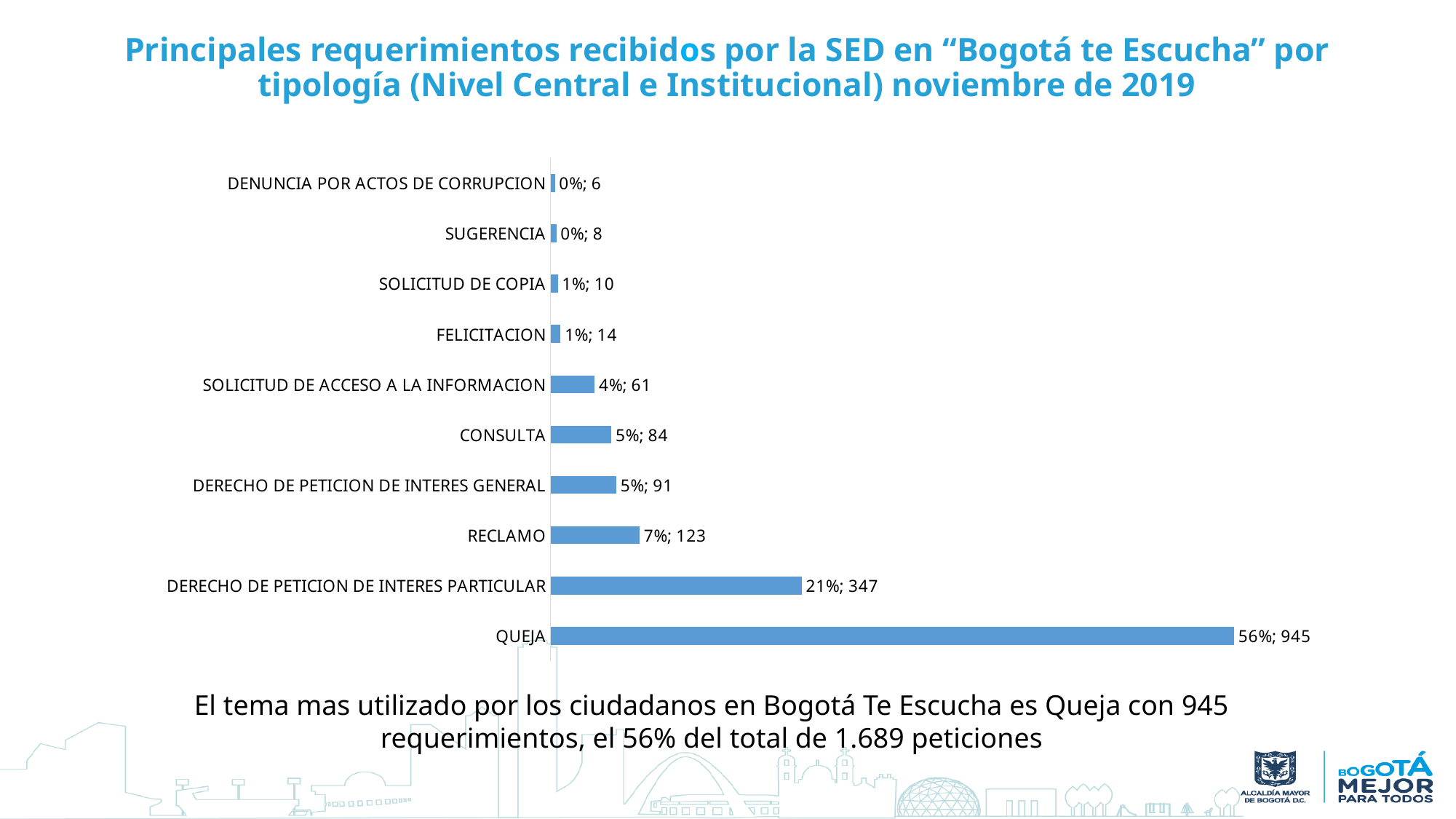
What kind of chart is shown on the slide? Bar chart Which category has the lowest number of requests? DENUNCIA POR ACTOS DE CORRUPCION What percentage share is shown for DERECHO DE PETICION DE INTERES PARTICULAR? 21% What is the difference in requests between QUEJA and DERECHO DE PETICION DE INTERES PARTICULAR? 598 Which has more requests, RECLAMO or CONSULTA? RECLAMO What is the number of requests for RECLAMO? 123 What is the number of requests for SOLICITUD DE ACCESO A LA INFORMACION? 61 What is the difference in requests between CONSULTA and SOLICITUD DE ACCESO A LA INFORMACION? 23 According to the text below the chart, what is the total number of petitions? 1.689 How many categories are shown in the chart? 10 Which category has the highest number of requests? QUEJA What is the number of requests for QUEJA? 945